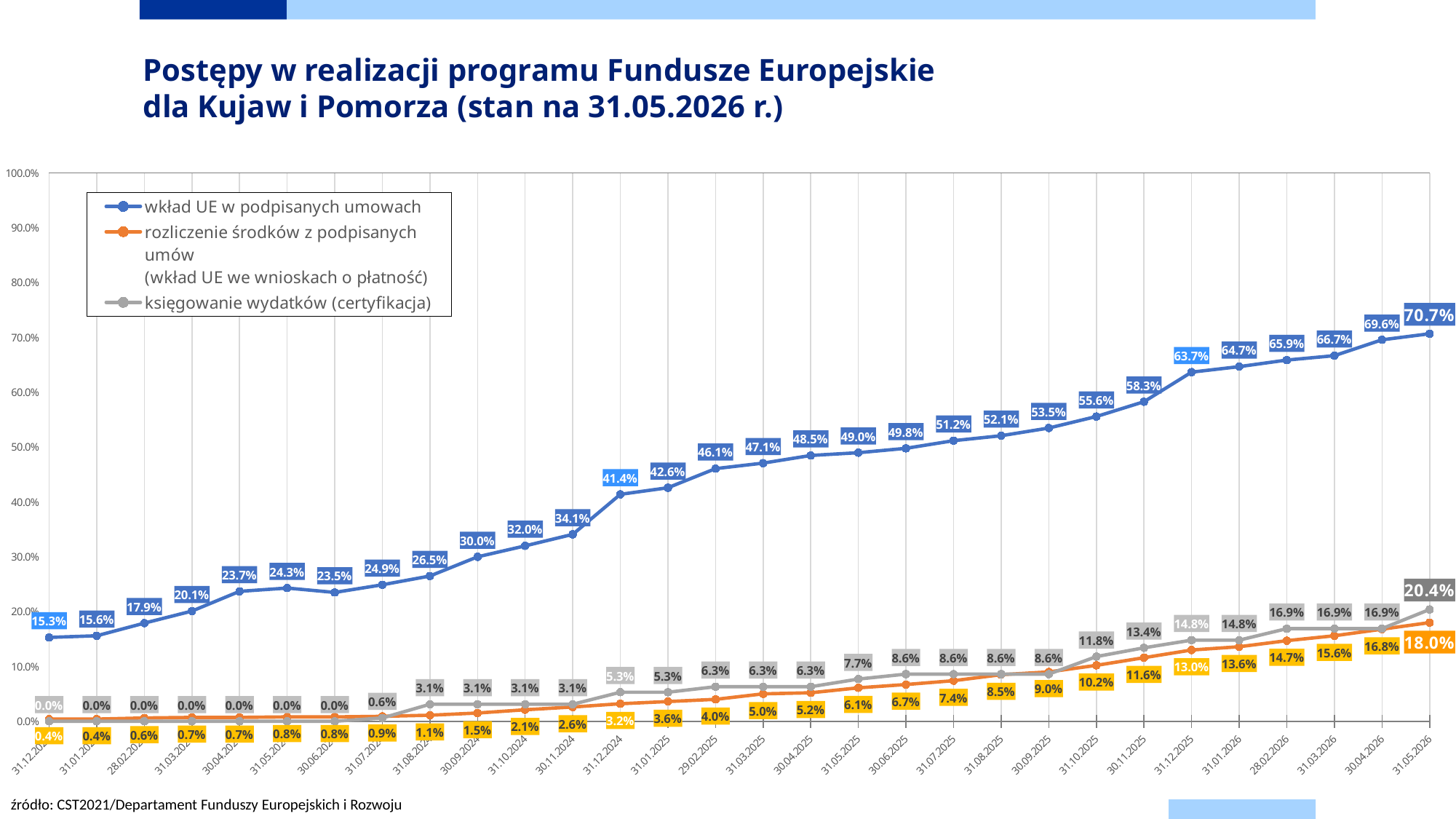
How many dates are plotted along the x axis? 30 Does the 'wkład UE w podpisanych umowach' series generally rise or fall from 31.12.2023 to 31.05.2026? rise What is the value of 'wkład UE w podpisanych umowach' on 31.05.2026? 70.7% What is the value of 'wkład UE w podpisanych umowach' on 31.12.2024? 41.4% By how many percentage points did 'wkład UE w podpisanych umowach' increase between 30.04.2026 and 31.05.2026? 1.1 percentage points On 31.05.2026, which is higher: 'księgowanie wydatków (certyfikacja)' or 'rozliczenie środków z podpisanych umów'? księgowanie wydatków (certyfikacja) What kind of chart is shown on the slide? line chart How many series does the legend list? 3 What is the value of 'rozliczenie środków z podpisanych umów' on 31.05.2026? 18.0% What is the value of 'rozliczenie środków z podpisanych umów' on 31.12.2025? 13.0% What is the value of 'księgowanie wydatków (certyfikacja)' on 31.05.2026? 20.4% On which date does 'wkład UE w podpisanych umowach' reach its highest value? 31.05.2026